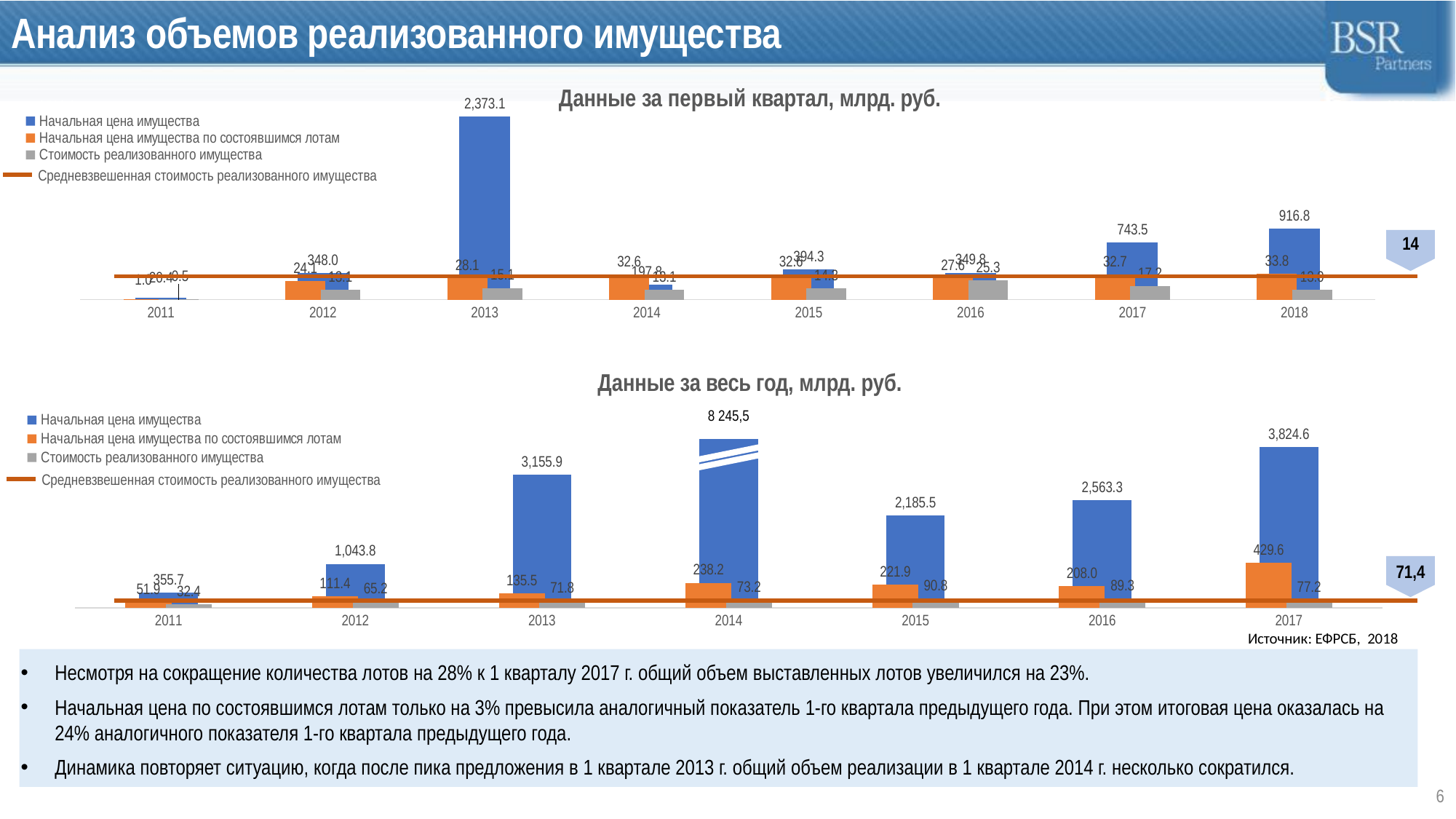
In the chart 'Данные за первый квартал, млрд. руб.', which year has the highest 'Начальная цена имущества'? 2013 In the chart 'Данные за первый квартал, млрд. руб.', what is the difference between 'Начальная цена имущества' in 2018 and in 2017? 173.3 In the chart 'Данные за весь год, млрд. руб.', is 'Начальная цена имущества' larger in 2013 or in 2015? 2013 In the chart 'Данные за весь год, млрд. руб.', what is the value of 'Начальная цена имущества по состоявшимся лотам' for 2017? 429.6 In the chart 'Данные за весь год, млрд. руб.', which year has the lowest 'Начальная цена имущества'? 2011 How many series does the legend of the chart 'Данные за весь год, млрд. руб.' list? 4 In the chart 'Данные за весь год, млрд. руб.', what is the difference between 'Начальная цена имущества' in 2017 and in 2016? 1,261.3 In the chart 'Данные за первый квартал, млрд. руб.', what is the value of 'Начальная цена имущества' for 2018? 916.8 In the chart 'Данные за весь год, млрд. руб.', what is the value of 'Стоимость реализованного имущества' for 2015? 90.8 In the chart 'Данные за весь год, млрд. руб.', what is the value of 'Начальная цена имущества' for 2014? 8 245,5 In the chart 'Данные за весь год, млрд. руб.', which year has the highest 'Начальная цена имущества'? 2014 How many years are shown on the x axis of the chart 'Данные за первый квартал, млрд. руб.'? 8